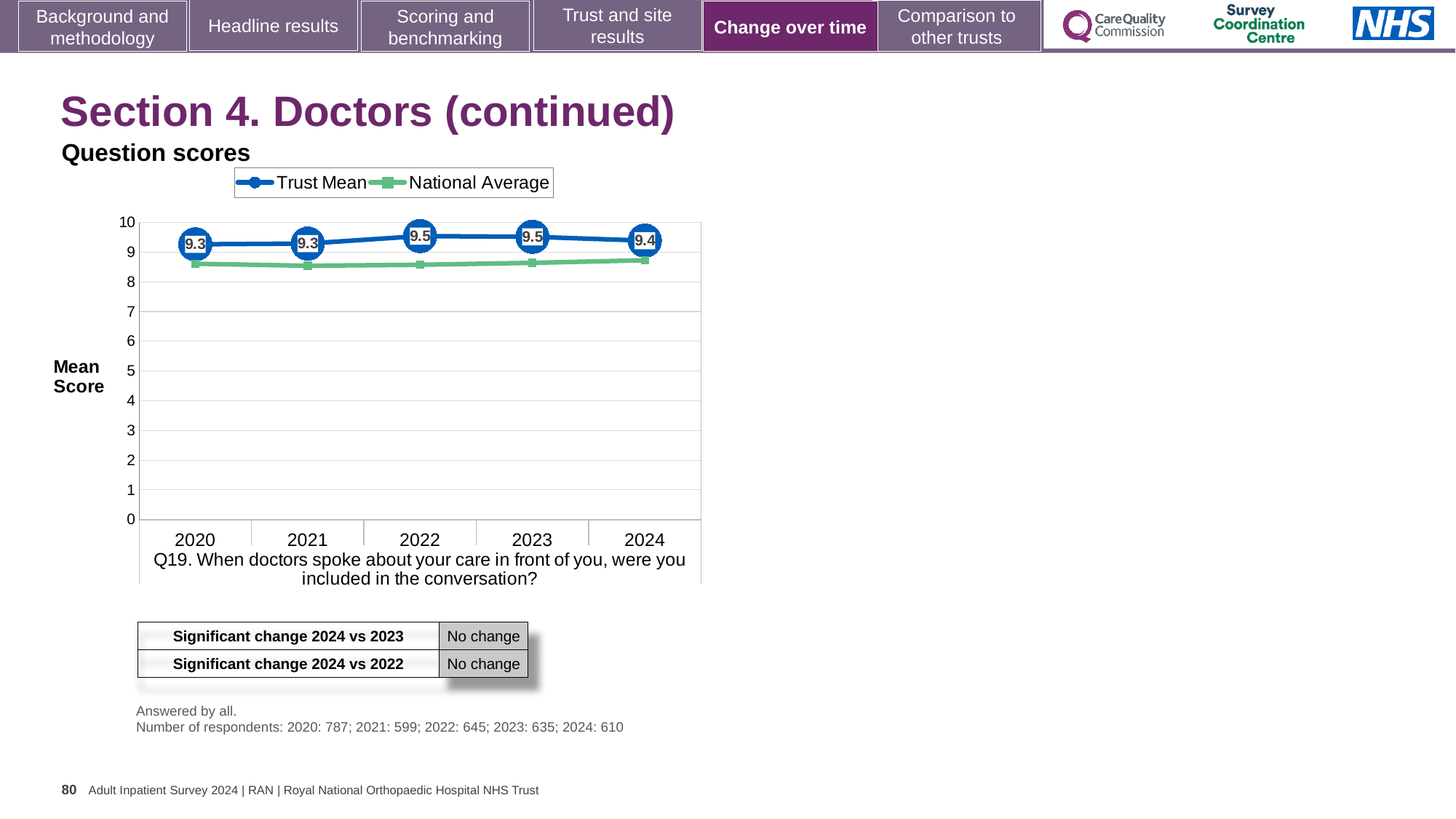
What is the Trust Mean value for 2020? 9.3 What is the difference between the Trust Mean in 2022 and the Trust Mean in 2020? 0.2 Is the National Average value for 2020 greater or less than 8? greater Which is larger, the Trust Mean in 2024 or the Trust Mean in 2021? 2024 How many years are plotted on the x axis? 5 How many series does the legend list? 2 Does the Trust Mean rise or fall from 2020 to 2022? Rise What is the Trust Mean value for 2022? 9.5 In 2024, which series has the higher value, Trust Mean or National Average? Trust Mean What kind of chart is shown on the slide? Line chart Is the National Average value for 2023 greater or less than 9? less What is the Trust Mean value for 2024? 9.4